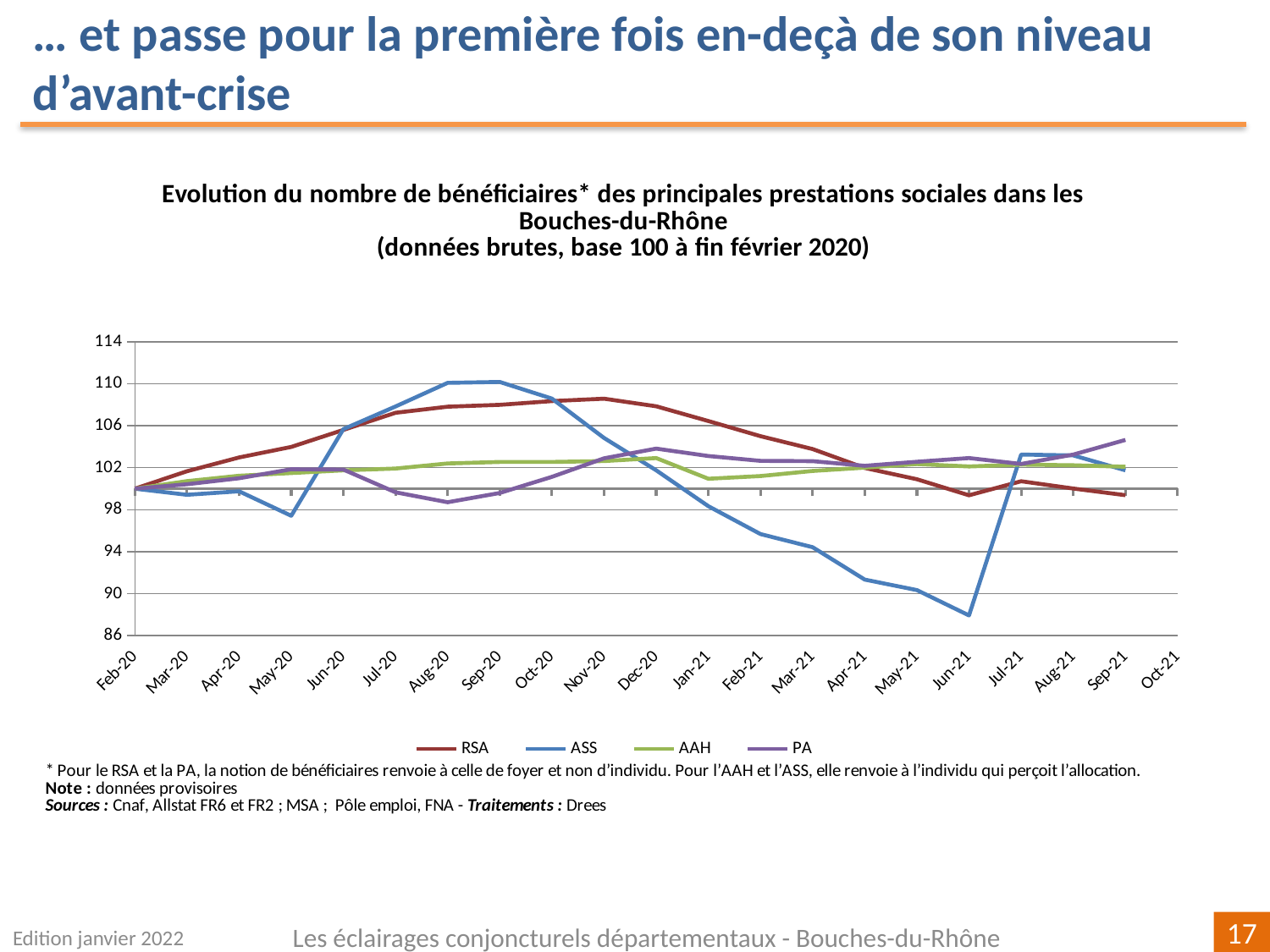
Is the value for PA in Sep-21 greater or less than 102? greater Is the value for ASS in Aug-20 greater or less than 106? greater What are the series names listed in the legend? RSA, ASS, AAH, PA What kind of chart is shown on the slide? line chart Is the value for RSA in Nov-20 greater or less than 106? greater Which series reaches the highest value on the chart? ASS How many series does the legend list? 4 Does the ASS series rise or fall between Sep-20 and Jun-21? fall What base period is used for the index of 100, according to the chart title? fin février 2020 In Jun-21, which series has the larger value, RSA or ASS? RSA Which series reaches the lowest value on the chart? ASS